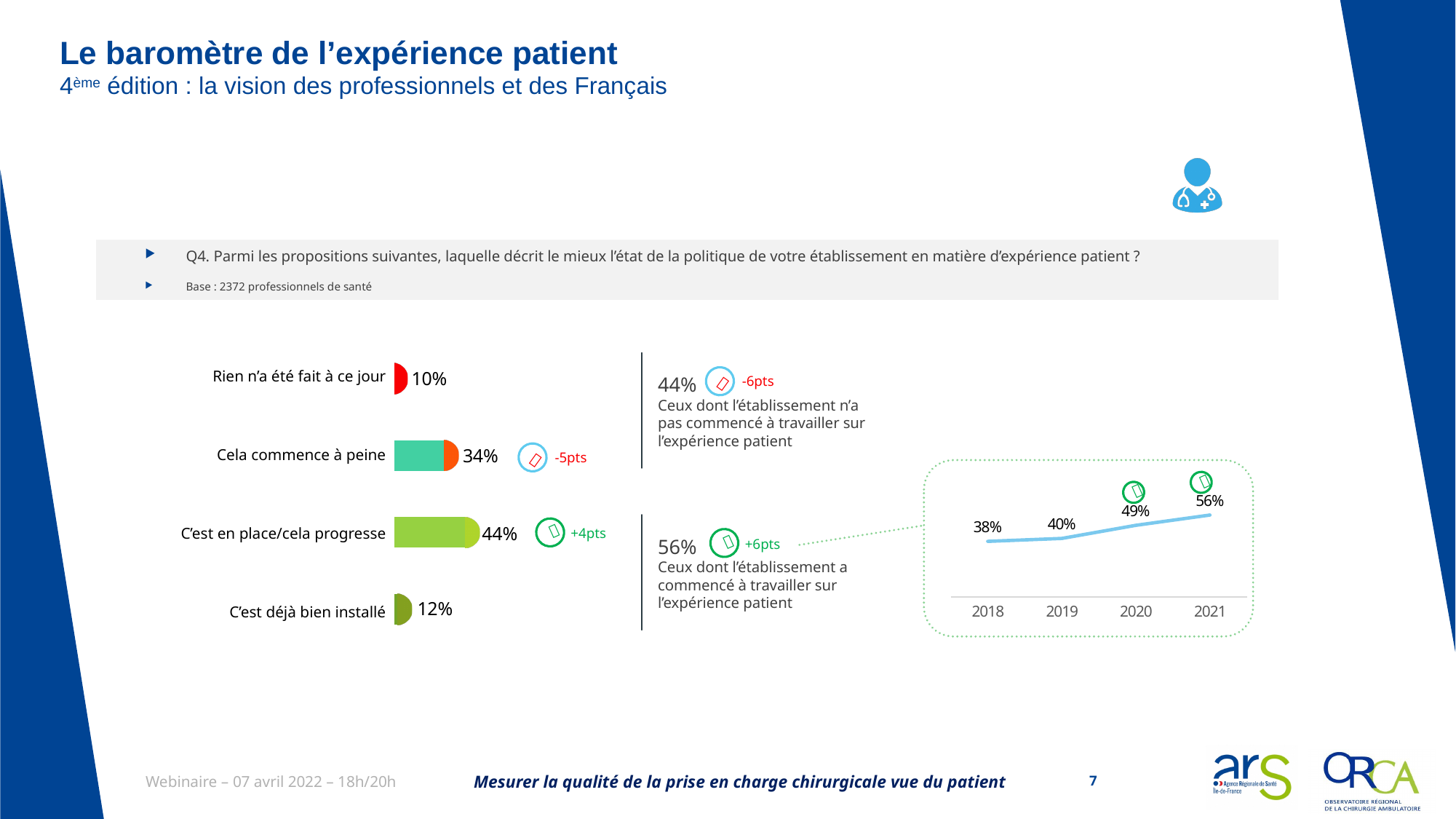
What kind of chart is shown on the left of the slide? Bar chart In the bar chart on the left, what is the value for "C'est déjà bien installé"? 12% In the line chart on the right, do the values rise or fall from 2018 to 2021? Rise In the bar chart on the left, which is larger: "Rien n'a été fait à ce jour" or "C'est déjà bien installé"? C'est déjà bien installé In the bar chart on the left, what is the difference between "C'est en place/cela progresse" and "Cela commence à peine"? 10 points In the line chart on the right, what is the value for 2018? 38% In the line chart on the right, what is the value for 2020? 49% In the bar chart on the left, what is the value for "Cela commence à peine"? 34% How many categories does the bar chart on the left show? 4 In the bar chart on the left, which category has the lowest value? Rien n'a été fait à ce jour In the line chart on the right, what is the difference between the 2021 and 2018 values? 18 points In the bar chart on the left, which category has the highest value? C'est en place/cela progresse